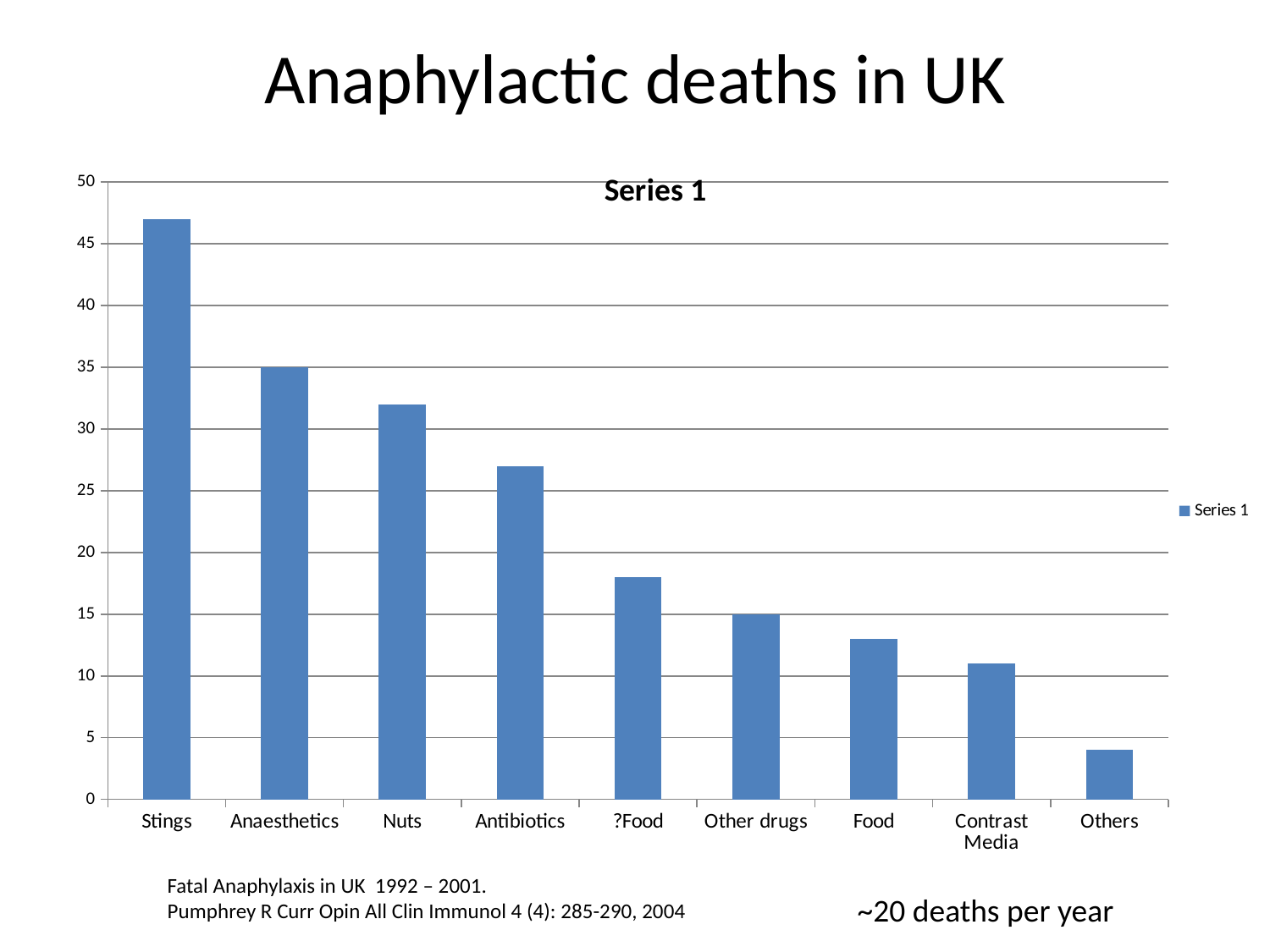
Is the value for Contrast Media greater or less than 10? greater What is the value for Other drugs? 15 Is the value for Stings greater or less than 45? greater How many categories are shown on the x axis of the chart? 9 Which is larger, the value for Antibiotics or the value for Food? Antibiotics What type of chart is shown on the slide? bar chart Is the value for Nuts greater or less than 30? greater How many series does the legend list? 1 Which category has the lowest value? Others What is the value for Anaesthetics? 35 Do the values rise or fall moving from left to right along the x axis? fall Which category has the highest value? Stings